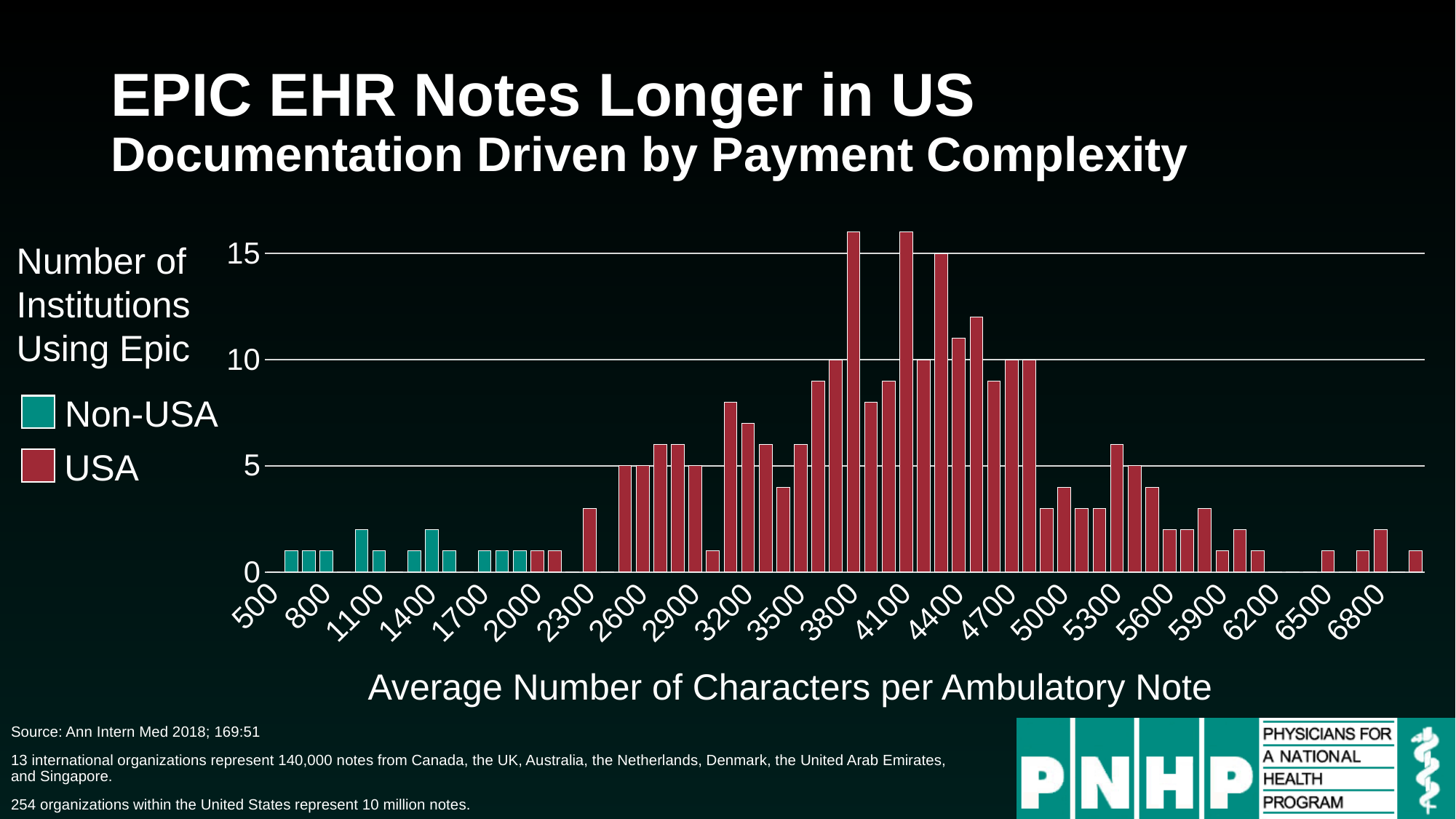
How many Non-USA (teal) bars are plotted? 11 Is the value of the tallest Non-USA bar greater or less than 5? less Which series has the tallest bar in the chart? USA Is the value of the tallest USA bar greater or less than 15? greater What is the title of the x axis? Average Number of Characters per Ambulatory Note What does the y axis measure? Number of Institutions Using Epic What are the two series named in the legend? Non-USA and USA How many labelled tick values are shown on the x axis? 22 How many series does the legend list? 2 Which series has its bars at higher average numbers of characters per note, Non-USA or USA? USA What is the highest tick value shown on the y axis? 15 What kind of chart is shown on the slide? bar chart